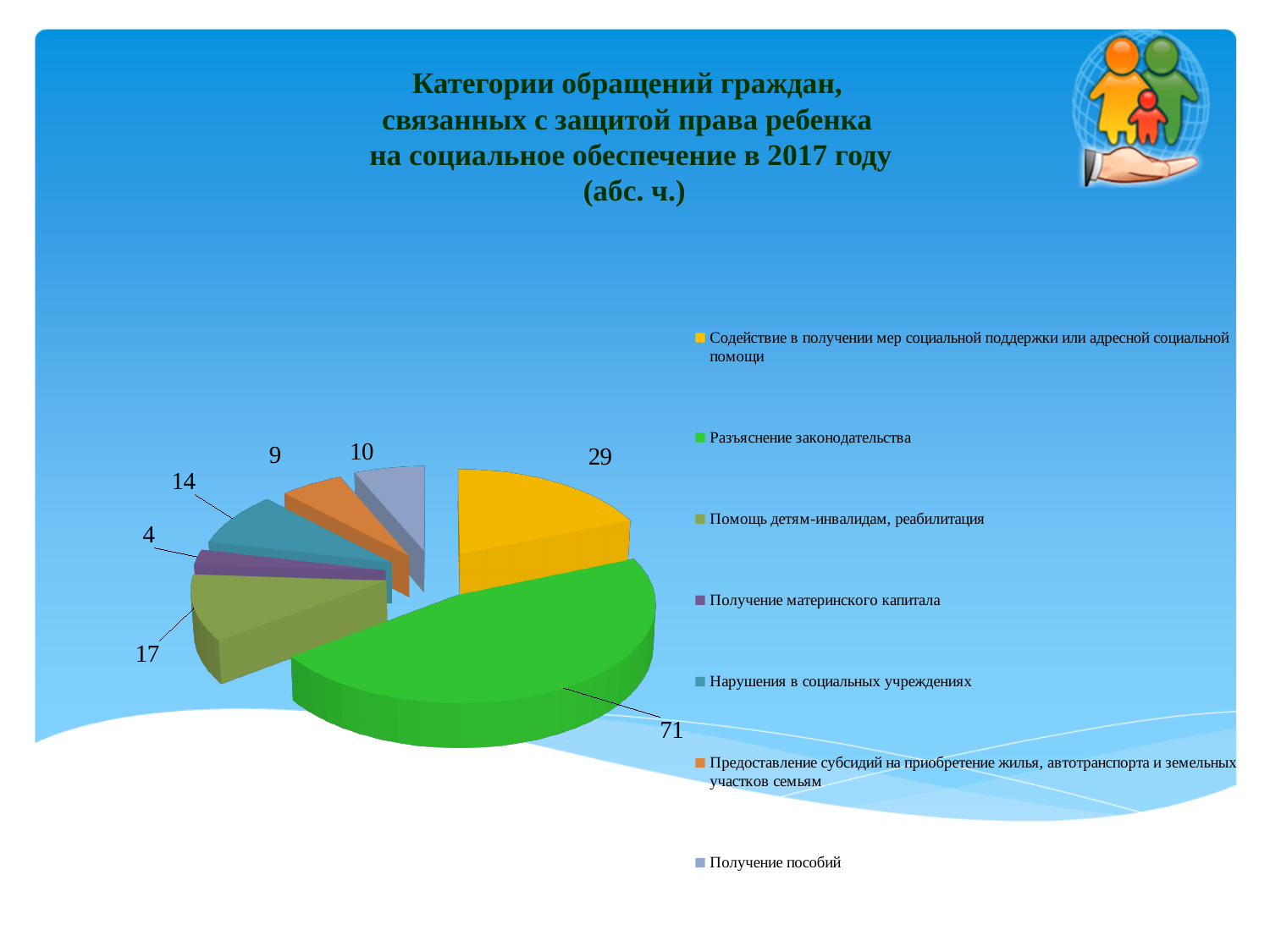
What is the value for "Содействие в получении мер социальной поддержки или адресной социальной помощи"? 29 Which is larger: the value for "Помощь детям-инвалидам, реабилитация" or the value for "Получение пособий"? Помощь детям-инвалидам, реабилитация What is the value for "Получение материнского капитала"? 4 What is the difference between the values for "Разъяснение законодательства" and "Содействие в получении мер социальной поддержки или адресной социальной помощи"? 42 What is the value for "Разъяснение законодательства"? 71 What is the value for "Нарушения в социальных учреждениях"? 14 Which colour represents "Предоставление субсидий на приобретение жилья, автотранспорта и земельных участков семьям" in the legend? orange What kind of chart is shown on the slide? pie chart How many categories does the pie chart show? 7 Which category has the smallest slice of the pie? Получение материнского капитала What is the total of all the values shown in the pie chart? 154 Which category has the largest slice of the pie? Разъяснение законодательства